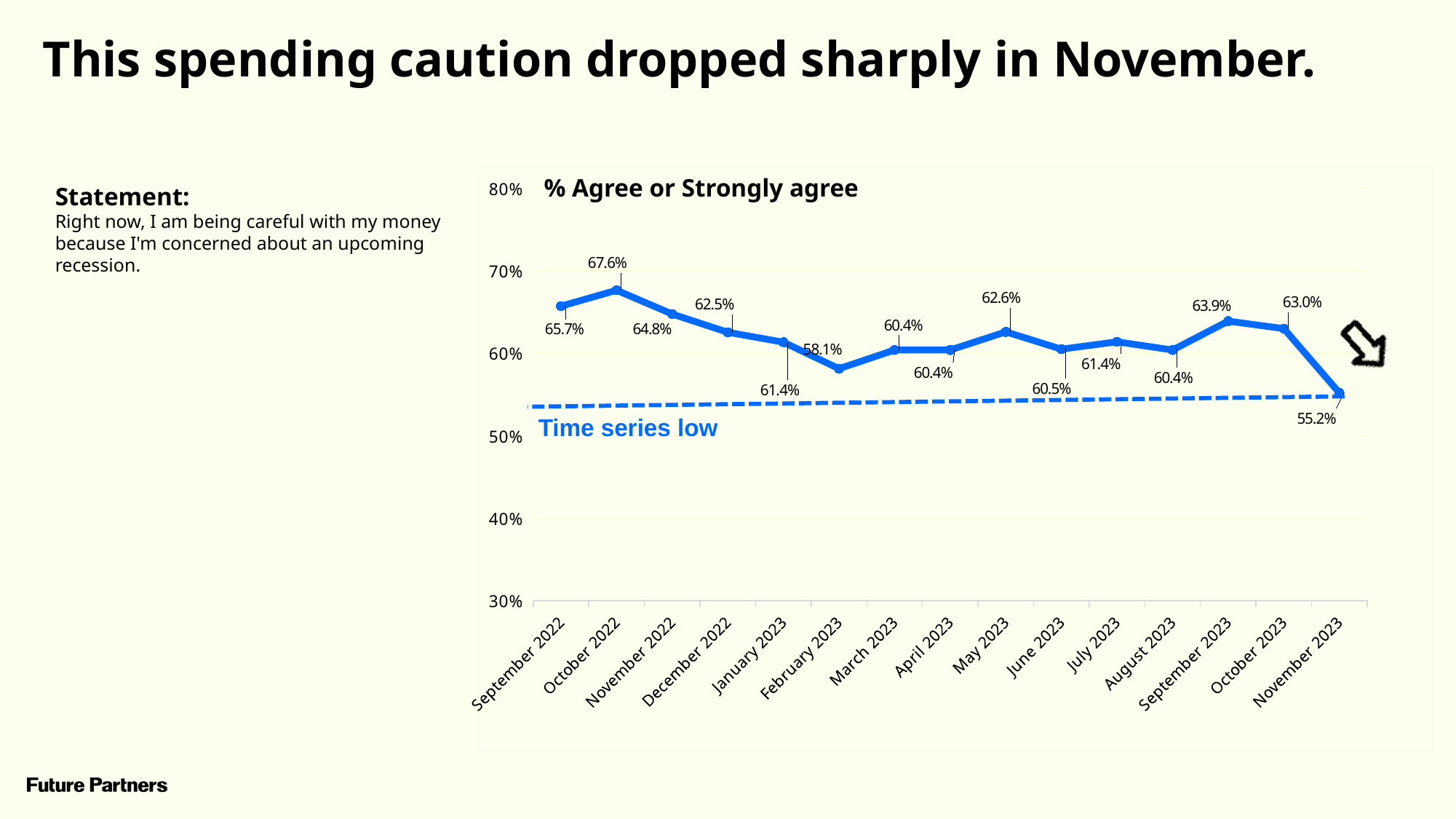
What is the value for November 2023? 55.2% Which month has the lowest value? November 2023 Is the value for February 2023 greater or less than 60%? less What is the difference between the October 2022 value and the November 2023 value? 12.4 percentage points Which month has the highest value? October 2022 What is the value for September 2023? 63.9% What is the value for February 2023? 58.1% What is the value for October 2022? 67.6% Which is larger, the value for May 2023 or the value for February 2023? May 2023 By how many percentage points did the value fall from October 2023 to November 2023? 7.8 percentage points What kind of chart is shown on the slide? Line chart How many months are plotted on the chart? 15